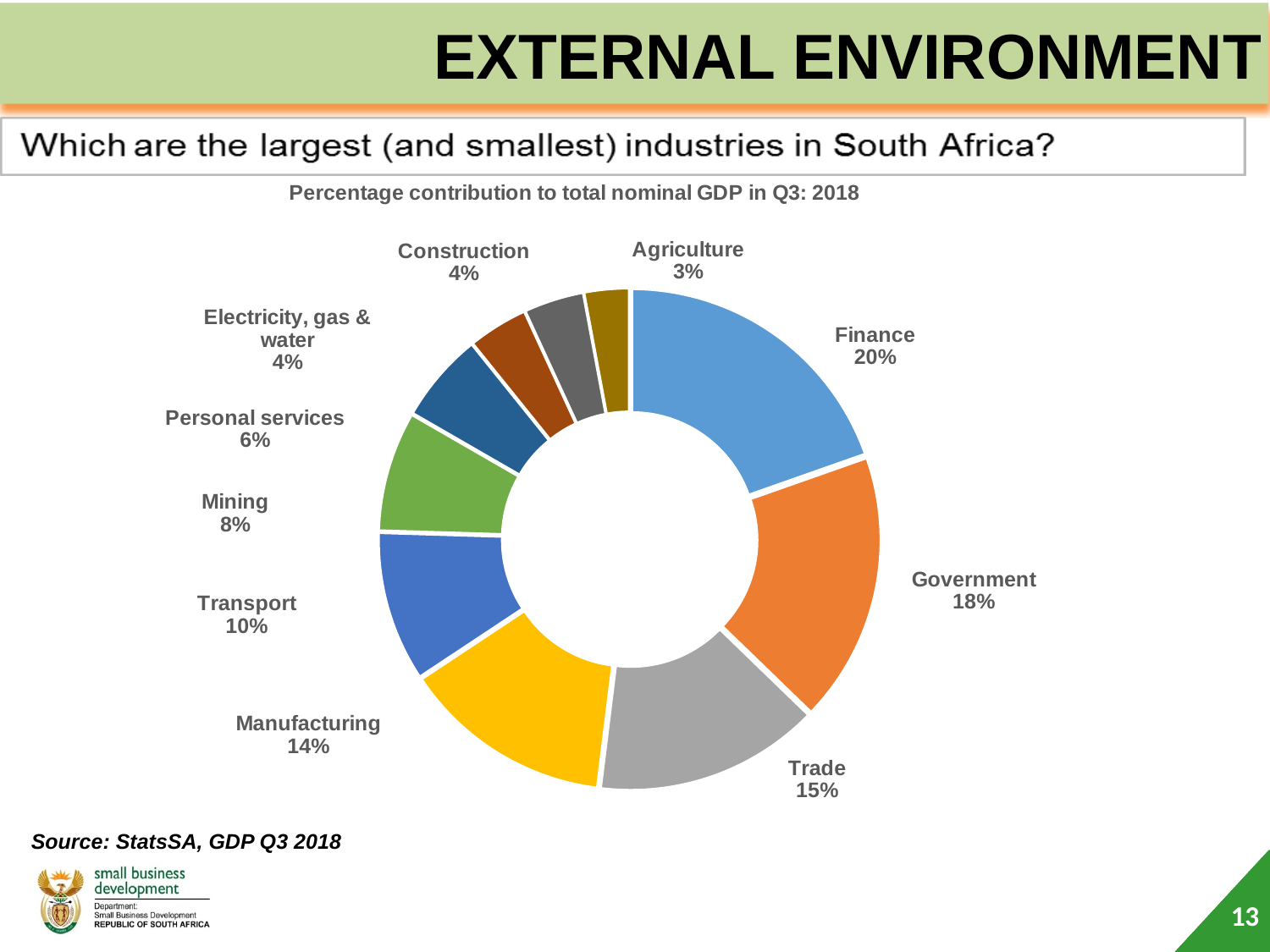
What percentage of total nominal GDP does Finance contribute? 20% Which contributes more to GDP, Trade or Manufacturing? Trade What type of chart is shown on the slide? Pie chart (doughnut) How many industries are shown in the chart? 10 What is the difference in percentage points between Finance and Government? 2% Which contributes more to GDP, Personal services or Mining? Mining What is the title of the chart? Percentage contribution to total nominal GDP in Q3: 2018 What is the percentage contribution of Mining? 8% What is the percentage contribution of Manufacturing? 14% What is the difference between Trade and Transport? 5% Which industry has the smallest share of nominal GDP? Agriculture Which industry has the largest share of nominal GDP? Finance